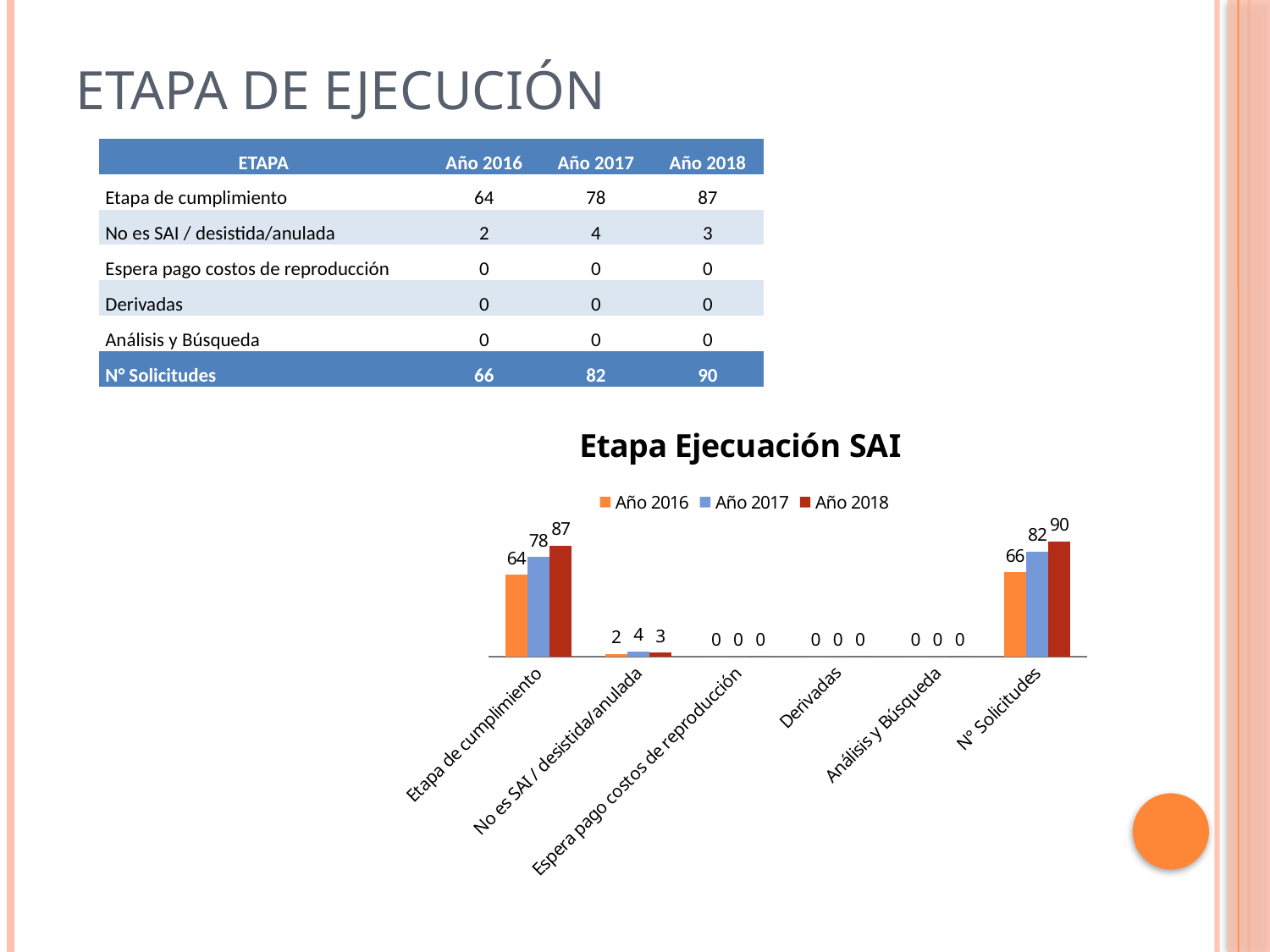
What kind of chart is shown? bar chart Which is larger for Etapa de cumplimiento: the Año 2017 value or the Año 2016 value? Año 2017 What is the title of the chart? Etapa Ejecuación SAI Do the values for Nº Solicitudes rise or fall from Año 2016 to Año 2018? rise What is the difference between the Año 2018 and Año 2016 values for Etapa de cumplimiento? 23 What is the value for No es SAI / desistida/anulada in Año 2017? 4 What is the value for Nº Solicitudes in Año 2016? 66 How many categories are shown on the x axis? 6 How many series does the legend list? 3 What is the value for Etapa de cumplimiento in Año 2018? 87 Which category has the highest value for Año 2018? Nº Solicitudes What is the value for Derivadas in Año 2016? 0